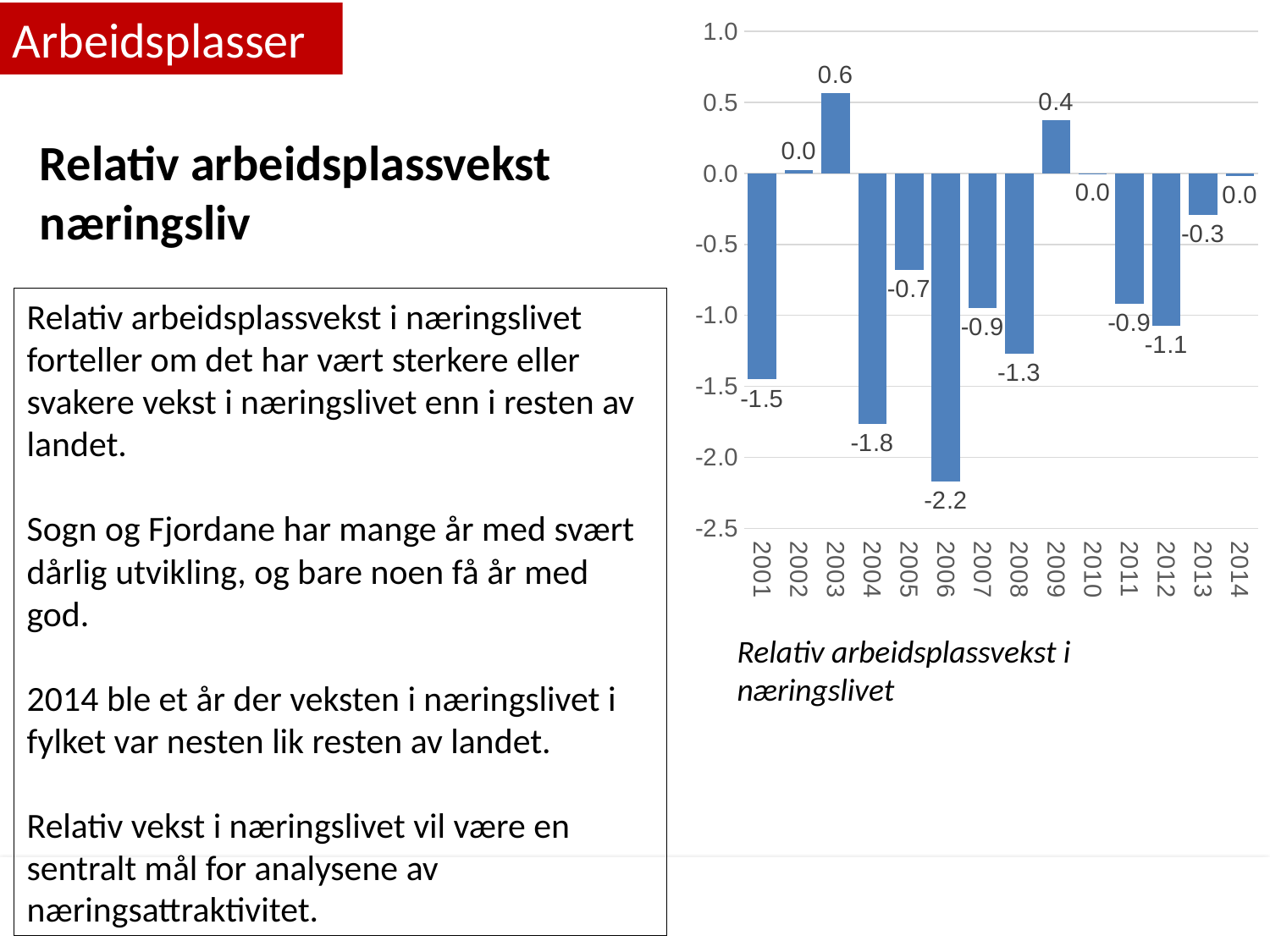
What kind of chart is shown on the slide? Bar chart What is the difference between the values for 2003 and 2009? 0.2 Which year has the highest value? 2003 What is the value for 2013? -0.3 Which year has the lowest value? 2006 How many years are shown on the x axis? 14 Is the value for 2004 greater or less than -1.5? less What is the value for 2006? -2.2 Which is larger, the value for 2001 or the value for 2008? 2008 What is the value for 2009? 0.4 What is the value for 2003? 0.6 What is the difference between the values for 2004 and 2006? 0.4